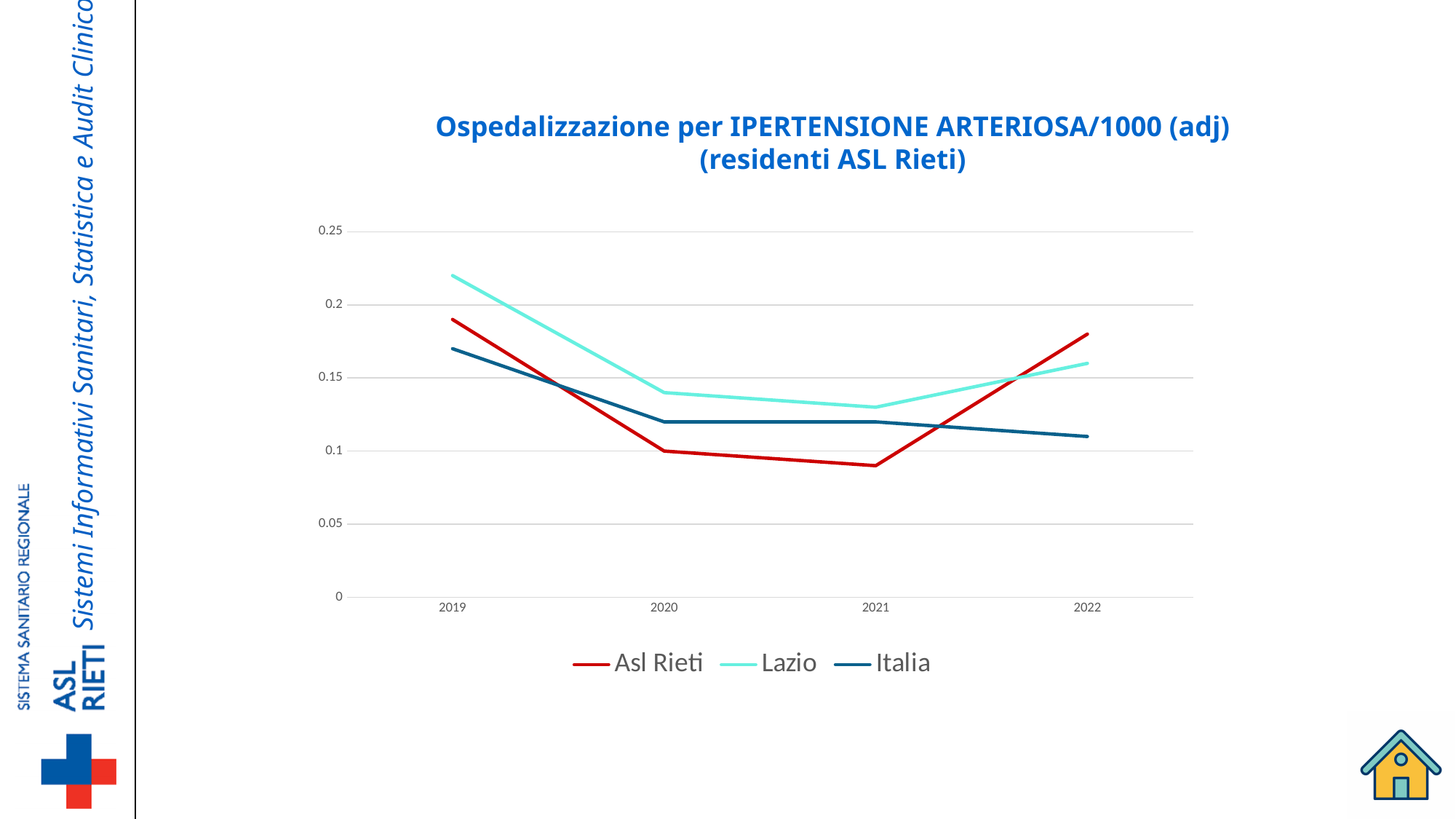
Is the value for Lazio in 2019 greater or less than 0.2? greater How many years are plotted on the x axis? 4 In which year does the Lazio series reach its highest value? 2019 Is the value for Asl Rieti in 2021 greater or less than 0.1? less Which series has the highest value in 2019? Lazio Which series is drawn in red? Asl Rieti Is the value for Asl Rieti in 2022 greater or less than 0.15? greater In which year does the Asl Rieti series reach its lowest value? 2021 Does the Italia series rise or fall from 2019 to 2022? fall How many series does the legend list? 3 What kind of chart is shown on the slide? line chart Which series has the higher value in 2022, Asl Rieti or Italia? Asl Rieti